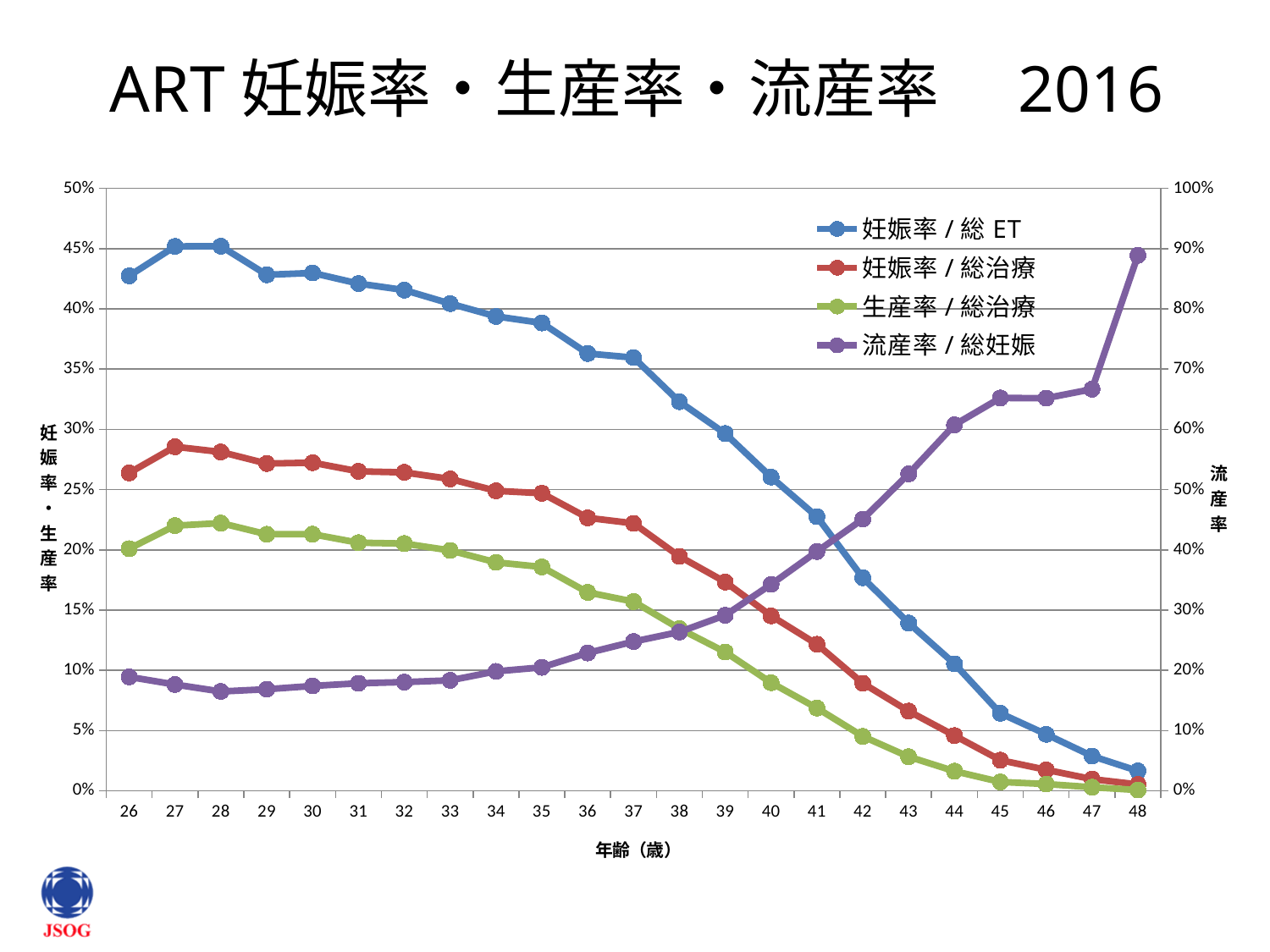
How many series does the legend list? 4 Is the value of 生産率 / 総治療 at age 36 greater or less than 15%? greater How many age categories are plotted along the x axis? 23 Is the value of 妊娠率 / 総 ET at age 26 greater or less than 40%? greater Is the value of 流産率 / 総妊娠 at age 48 greater or less than 80% on the right axis? greater Does the 妊娠率 / 総 ET series generally rise or fall as age increases from 28 to 48? fall What is the title of the chart on the slide? ART 妊娠率・生産率・流産率 2016 Does the 流産率 / 総妊娠 series generally rise or fall as age increases? rise At age 35, which series is higher: 妊娠率 / 総 ET or 妊娠率 / 総治療? 妊娠率 / 総 ET What kind of chart is shown on the slide? line chart